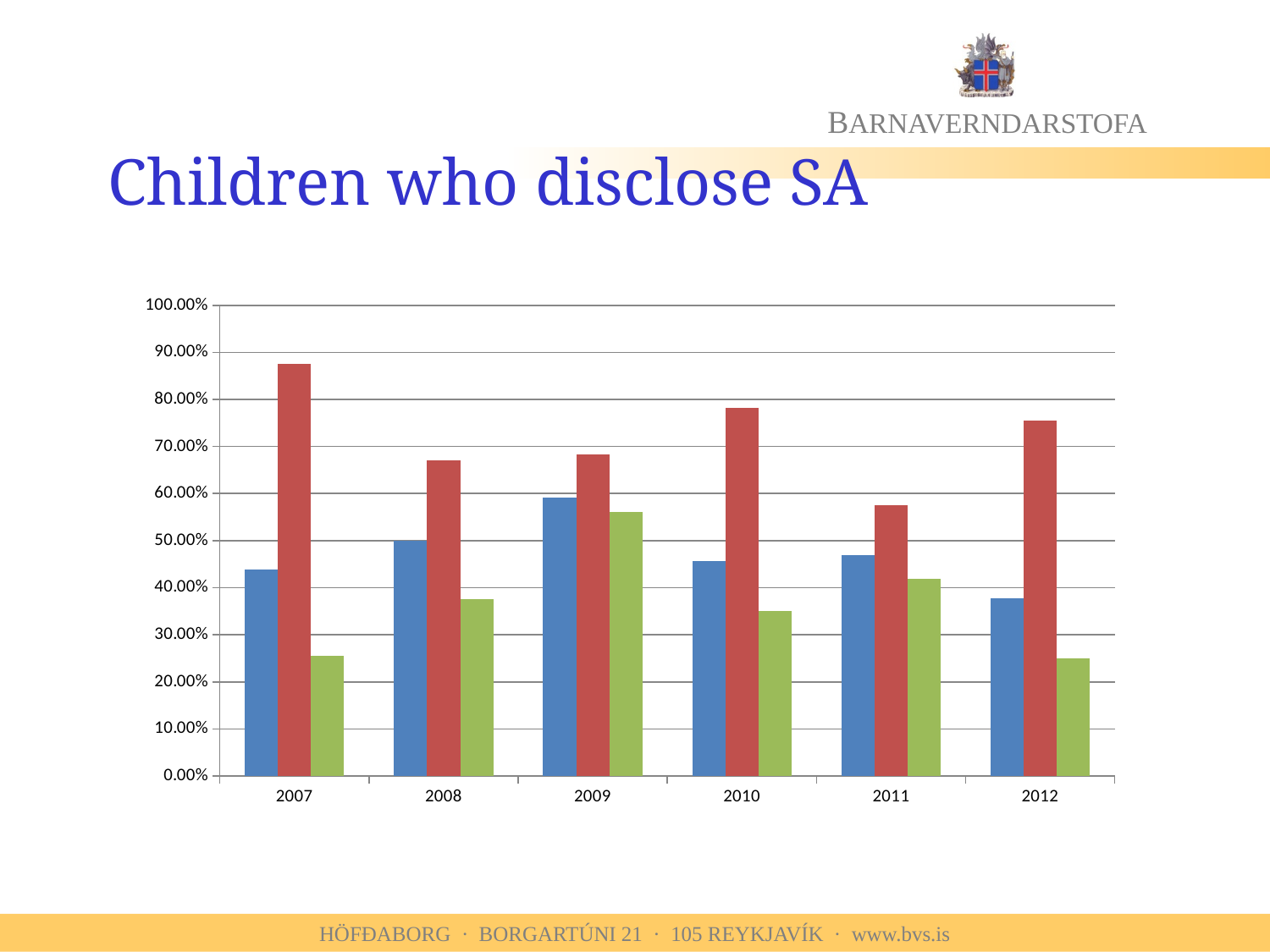
Which is larger, the red bar for 2007 or the red bar for 2012? the red bar for 2007 Is the value of the green bar for 2007 greater or less than 30.00%? less What kind of chart is shown on the slide? bar chart In which year is the green bar the tallest? 2009 How many years are shown along the x axis of the chart? 6 Is the value of the red bar for 2011 greater or less than 60.00%? less In which year is the red bar the shortest? 2011 What is the title of the slide's chart? Children who disclose SA Is the value of the red bar for 2007 greater or less than 80.00%? greater In which year is the blue bar the tallest? 2009 How many bars are plotted for each year in the chart? 3 In which year is the red bar the tallest? 2007